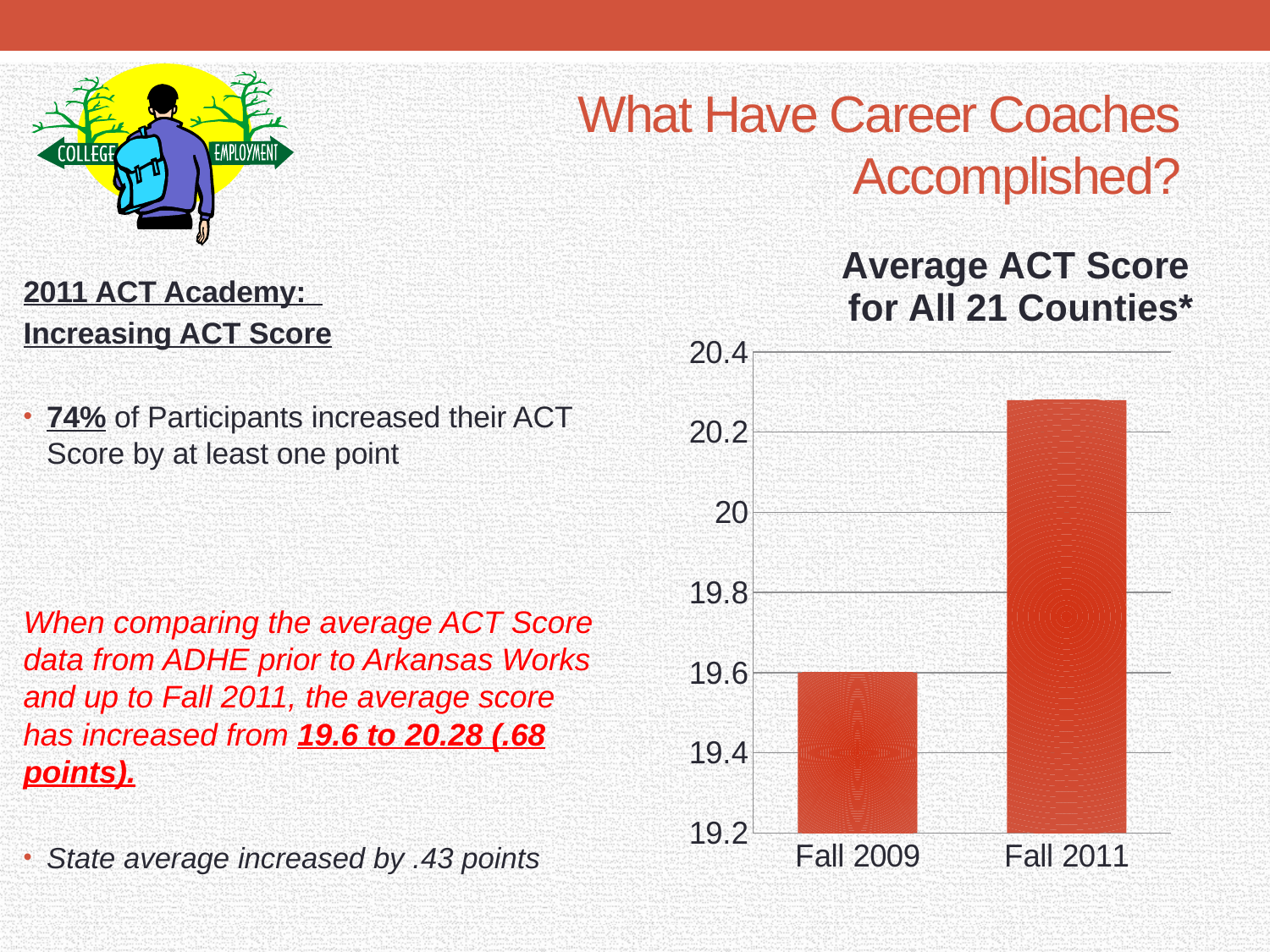
What is the title of the chart? Average ACT Score for All 21 Counties* Which category has the highest average ACT score in the chart? Fall 2011 Which category has the lowest average ACT score in the chart? Fall 2009 How many categories are plotted in the chart? 2 Which is larger in the chart, the value for Fall 2009 or Fall 2011? Fall 2011 What colour are the bars in the chart? red Is the value for Fall 2011 greater or less than 20.4? less Do the values rise or fall from Fall 2009 to Fall 2011? rise What is the average ACT score shown for Fall 2009? 19.6 Is the value for Fall 2009 greater or less than 20? less What kind of chart is shown on the slide? bar chart Is the value for Fall 2011 greater or less than 20.2? greater